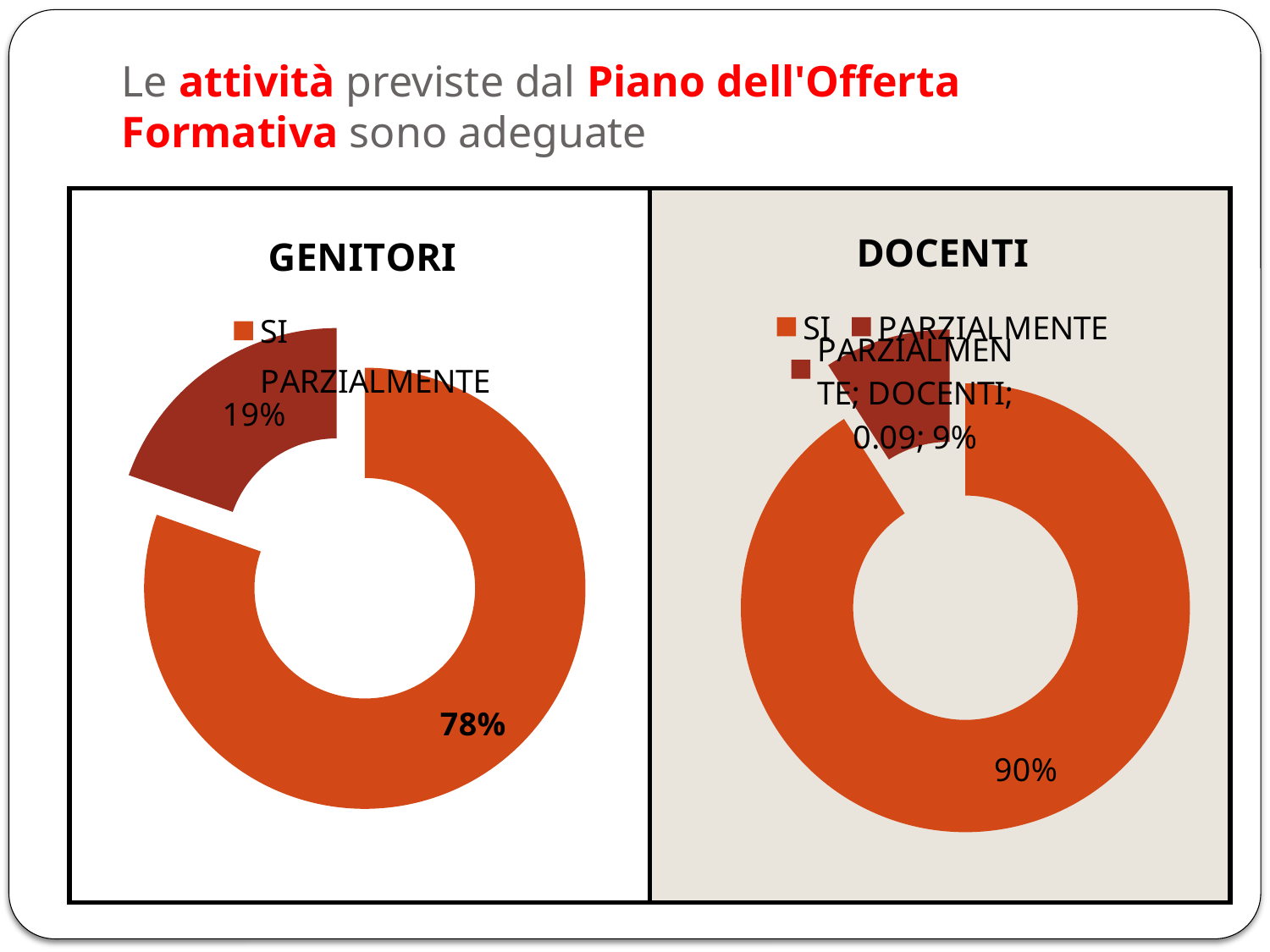
How many categories does the legend of the GENITORI chart list? 2 In the GENITORI chart, which category has the largest share? SI In the DOCENTI chart, what percentage is shown for SI? 90% In the GENITORI chart, what percentage is shown for SI? 78% In the GENITORI chart, what is the difference between the SI and PARZIALMENTE percentages? 59% Which chart shows a higher percentage for SI, GENITORI or DOCENTI? DOCENTI What is the title of the chart on the right side of the slide? DOCENTI In the GENITORI chart, what percentage is shown for PARZIALMENTE? 19% What kind of chart is the DOCENTI chart? Doughnut (pie) chart In the DOCENTI chart, what is the difference between the SI and PARZIALMENTE percentages? 81% In the DOCENTI chart, which category has the smallest share? PARZIALMENTE In the DOCENTI chart, what percentage is shown for PARZIALMENTE? 9%